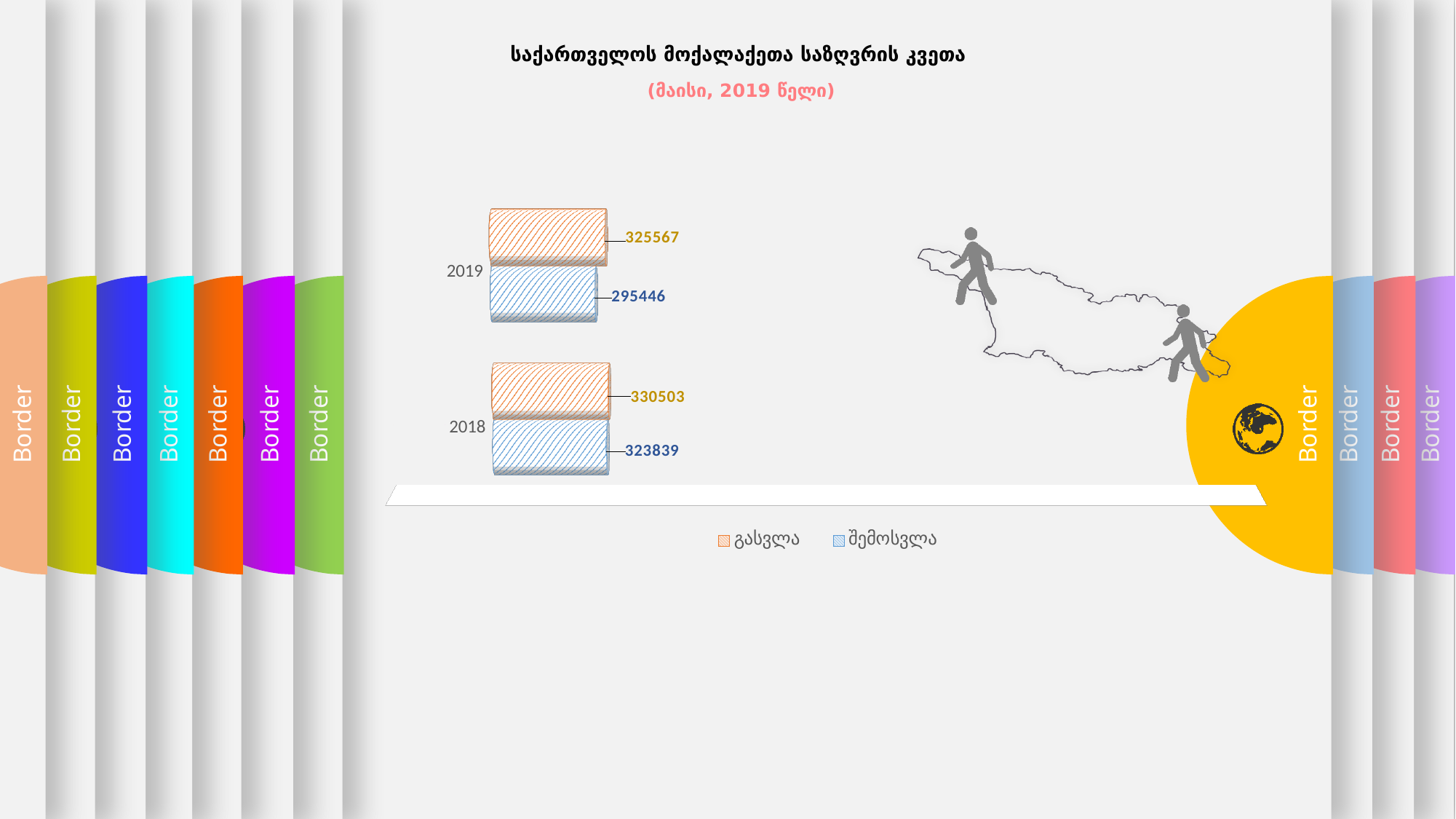
How many years are shown on the chart? 2 What is the difference between the გასვლა values for 2018 and 2019? 4936 What is the difference between გასვლა and შემოსვლა in 2019? 30121 What is the value for გასვლა in 2019? 325567 Which year has the higher value for შემოსვლა? 2018 What is the value for შემოსვლა in 2018? 323839 Which year has the higher value for გასვლა? 2018 What is the difference between გასვლა and შემოსვლა in 2018? 6664 What is the value for შემოსვლა in 2019? 295446 What is the value for გასვლა in 2018? 330503 How many series does the legend list? 2 What kind of chart is shown on the slide? Bar chart